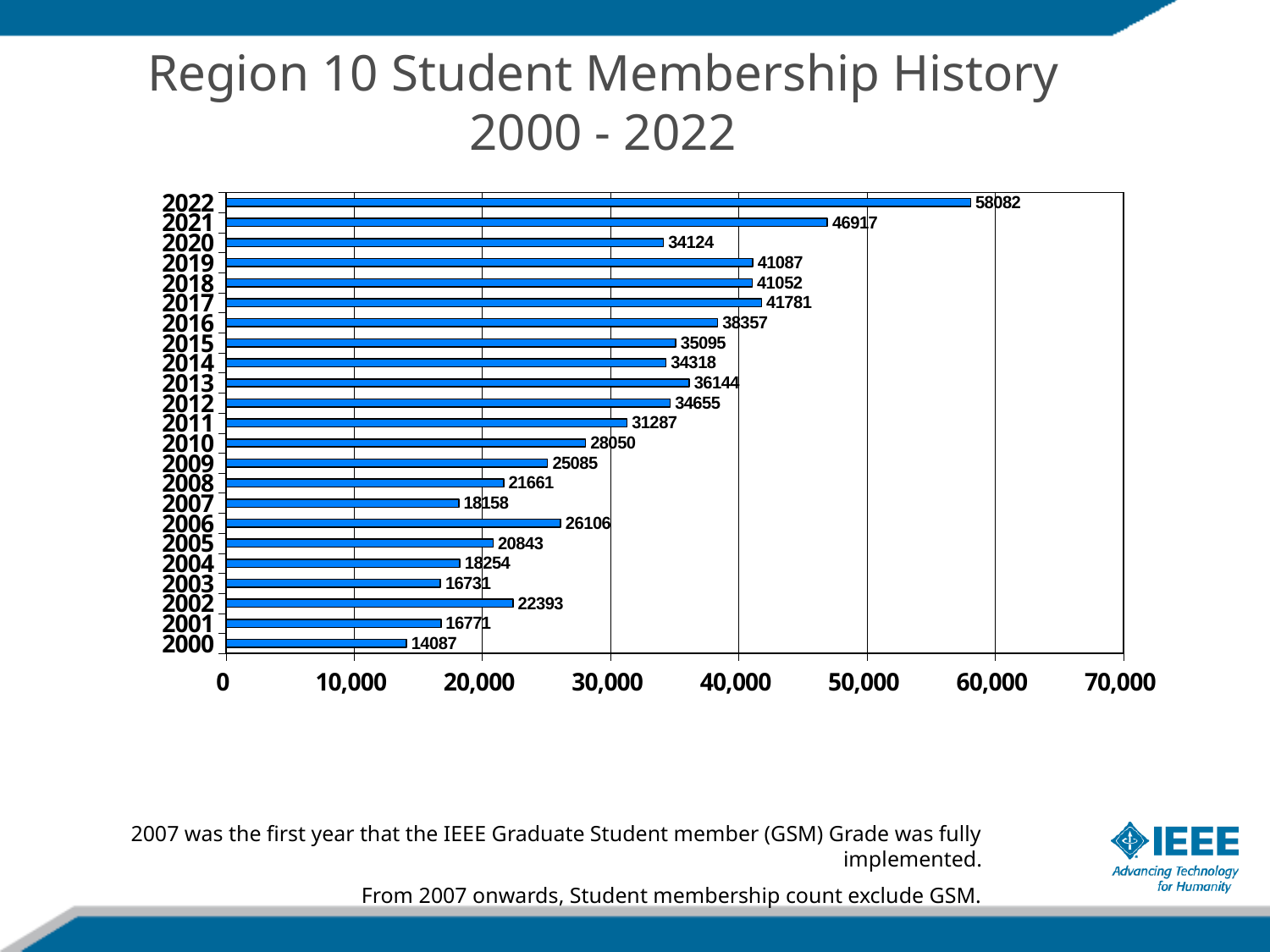
What is the title of the chart on the slide? Region 10 Student Membership History 2000 - 2022 What is the student membership value for 2013? 36144 Which year has the highest student membership? 2022 What is the difference between the 2022 and 2021 membership values? 11165 Which year has the lowest student membership? 2000 How many years are shown in the chart? 23 What is the difference between the 2006 and 2005 membership values? 5263 Which year has the larger membership, 2017 or 2016? 2017 What is the student membership value for 2007? 18158 Is the value for 2010 greater or less than 20,000? greater What is the student membership value for 2022? 58082 What kind of chart is shown on the slide? Bar chart